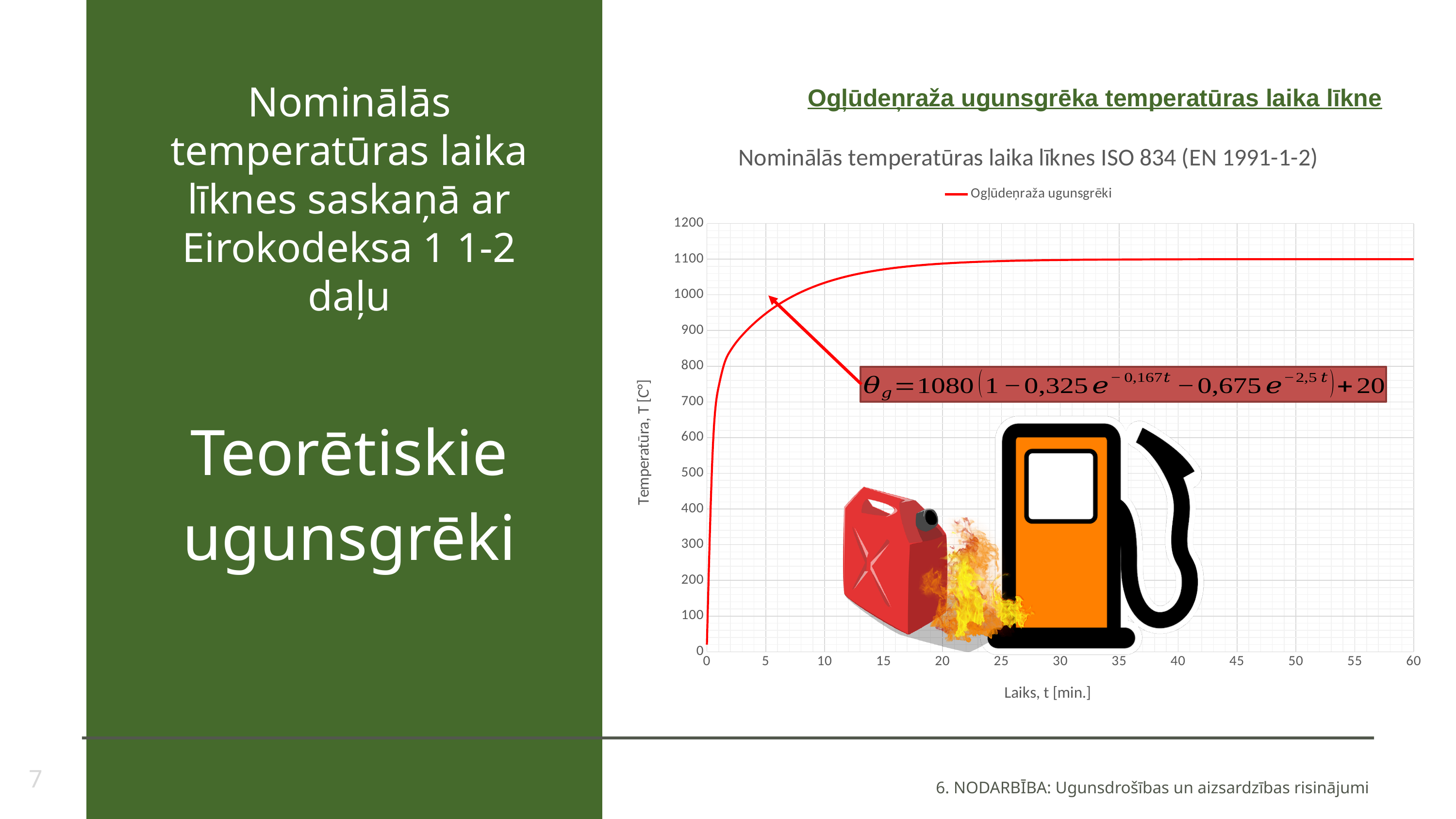
Is the temperature at 40 minutes greater or less than the temperature at 2 minutes? greater Does the temperature curve rise or fall as time increases along the x axis? rise Is the temperature value at 60 minutes greater or less than 1200? less Is the temperature value at 0 minutes greater or less than 100? less Is the temperature value at 10 minutes greater or less than 900? greater What kind of chart is shown on the slide? line chart What is the name of the series shown in the chart legend? Ogļūdeņraža ugunsgrēki What is the title of the chart? Nominālās temperatūras laika līknes ISO 834 (EN 1991-1-2) How many series does the chart legend list? 1